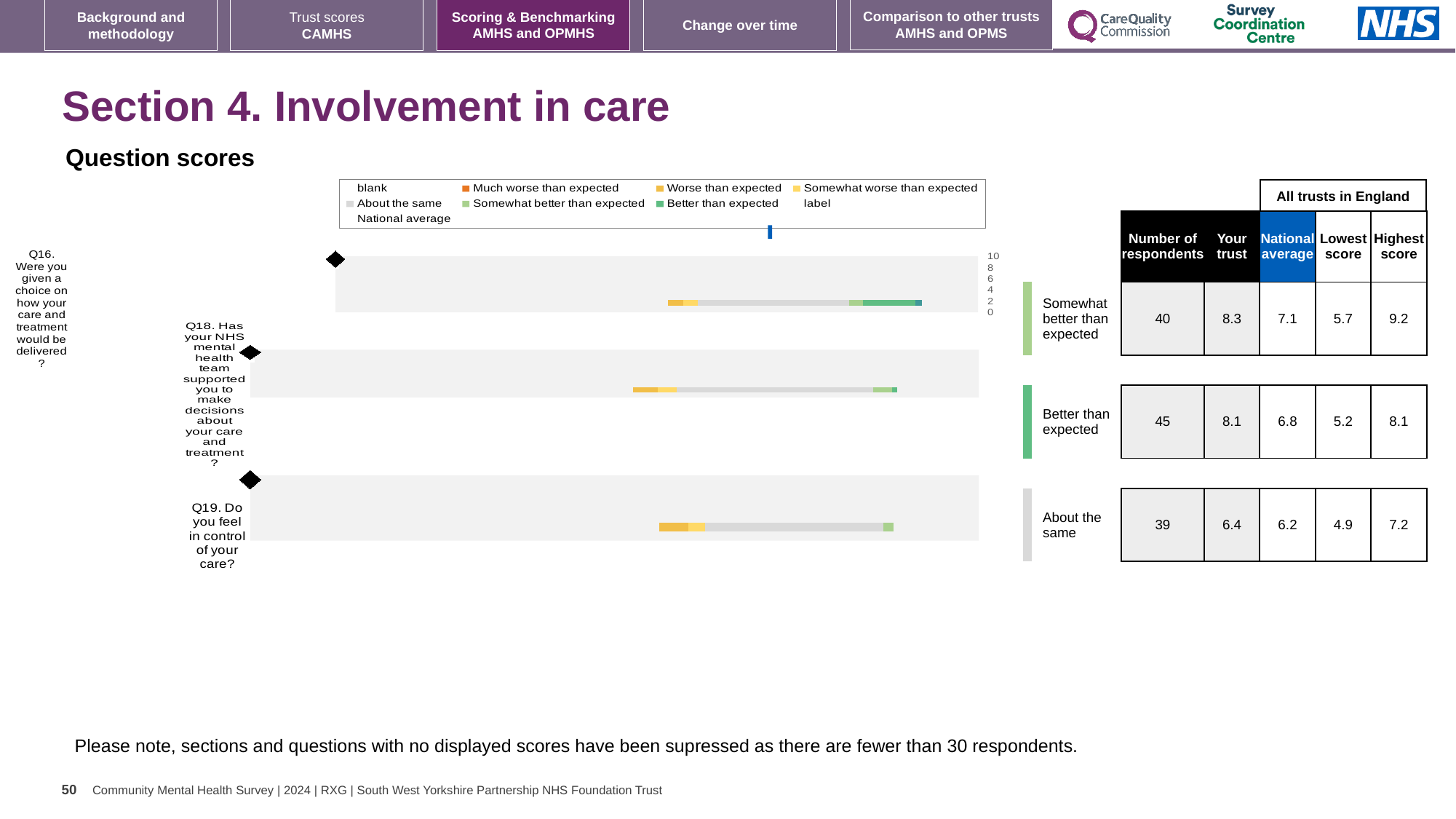
What kind of chart is used to show the question scores on this slide? bar chart How many respondents answered Q19 (Do you feel in control of your care?)? 39 How many questions are plotted in the question scores chart? 3 What is the highest score across all trusts in England for Q16? 9.2 What is the difference between the 'Your trust' score and the national average for Q18? 1.3 Which question has the most respondents? Q18 What is the 'Your trust' score for Q16 (Were you given a choice on how your care and treatment would be delivered?)? 8.3 What is the national average score for Q18 (Has your NHS mental health team supported you to make decisions about your care and treatment?)? 6.8 Which benchmark category is shown for Q18? Better than expected Which has the larger 'Your trust' score, Q16 or Q19? Q16 Which question has the highest 'Your trust' score? Q16 Which question has the lowest 'Your trust' score? Q19